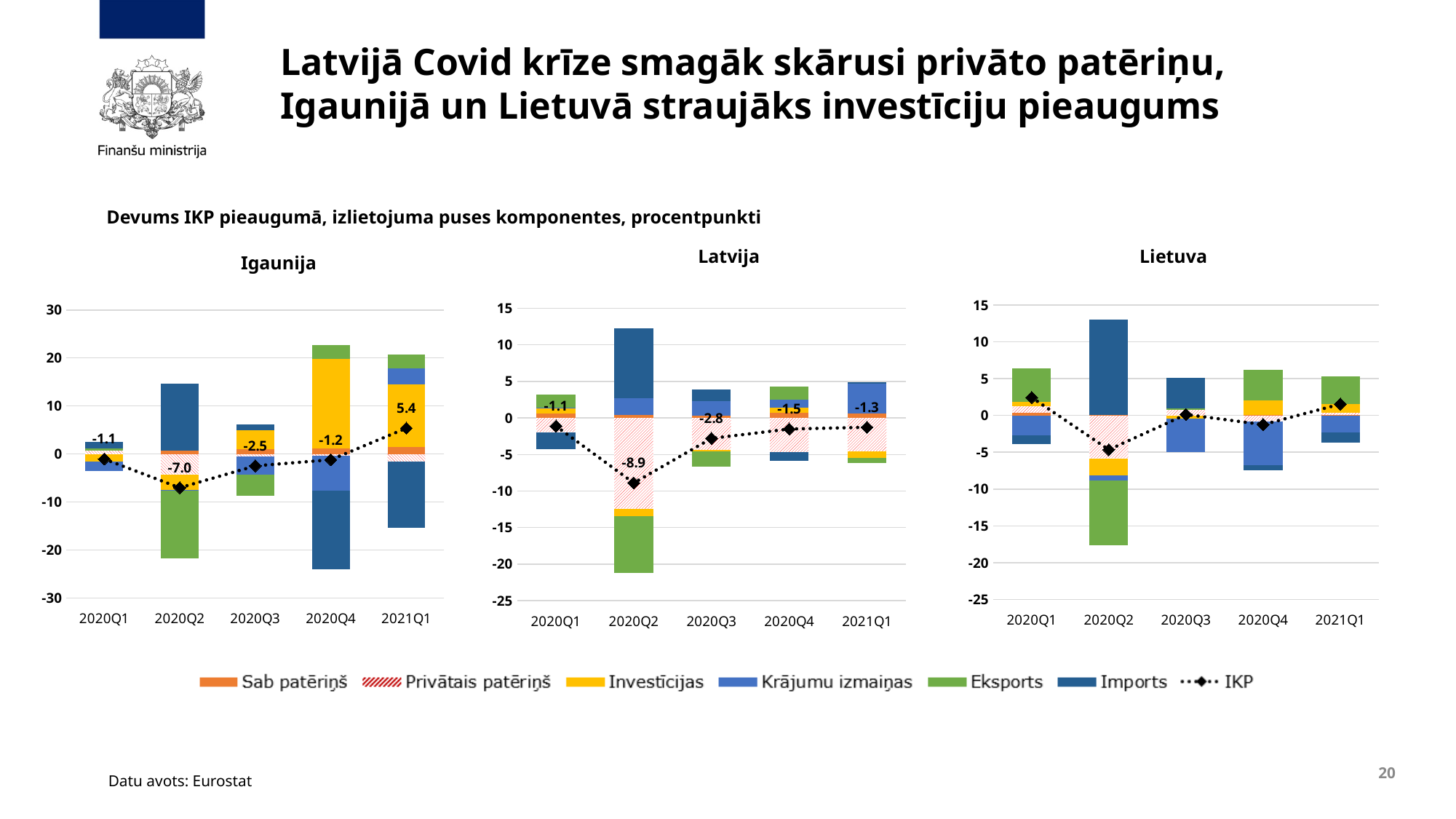
What kind of chart is the Igaunija chart? combination stacked bar and line chart In the Latvija chart, what is the IKP value for 2020Q2? -8.9 In the Igaunija chart, what is the IKP value for 2021Q1? 5.4 How many quarters are shown on the x axis of the Lietuva chart? 5 In the Igaunija chart, which quarter has the lowest IKP value? 2020Q2 In the Latvija chart, does the IKP line rise or fall from 2020Q2 to 2021Q1? rise In the Lietuva chart, is the IKP value for 2020Q2 greater or less than 0? less What is the title of the Igaunija chart's IKP line series in the legend? IKP In the Igaunija chart, what is the difference between the IKP values for 2021Q1 and 2020Q2? 12.4 In the Latvija chart, which quarter has the larger IKP value, 2020Q3 or 2020Q4? 2020Q4 How many series does the shared legend list? 7 In the Latvija chart, which quarter has the highest IKP value? 2020Q1